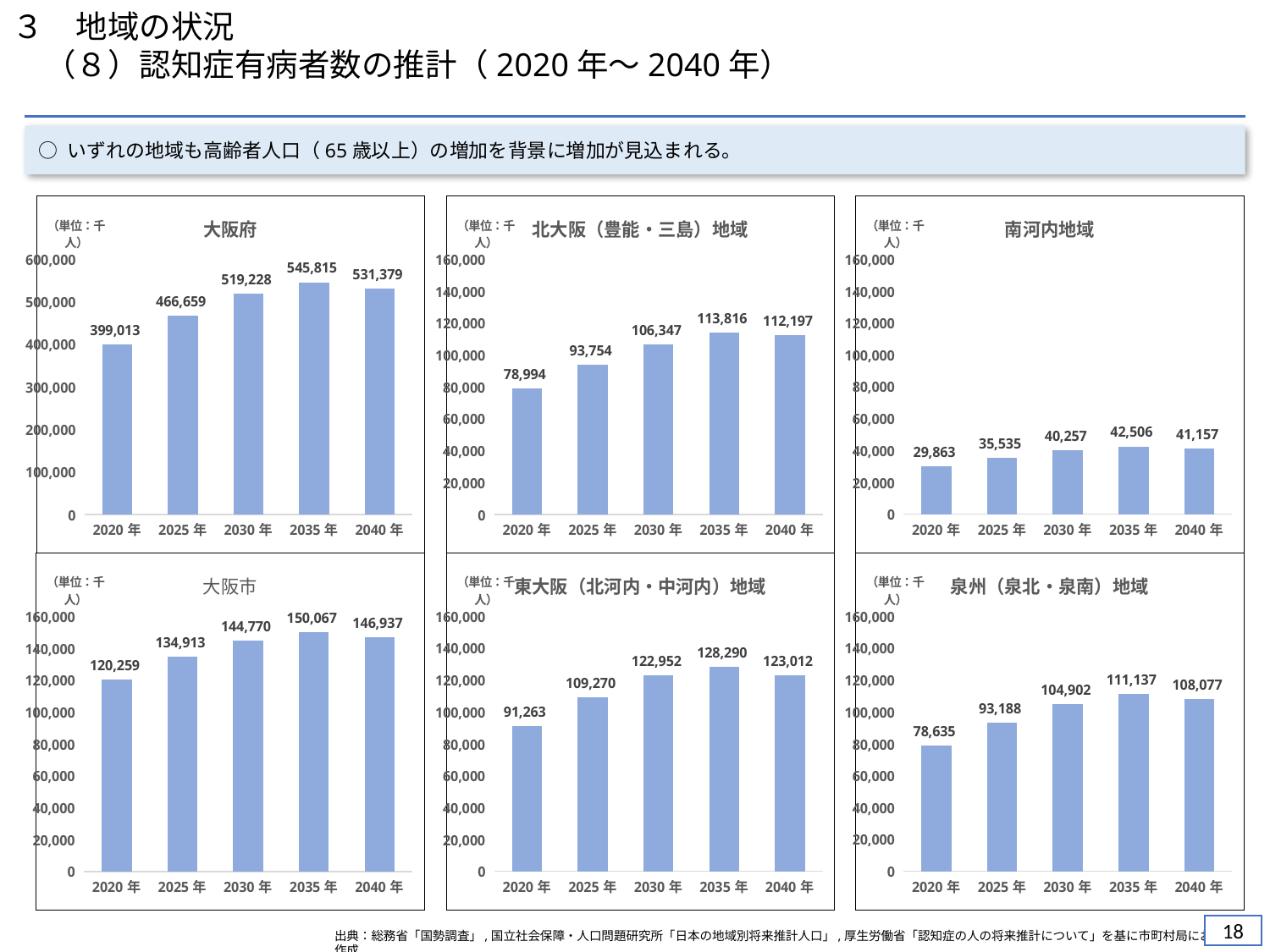
In the 大阪府 chart, what is the value for 2020年? 399,013 In the 南河内地域 chart, what is the difference between the 2035年 and 2020年 values? 12,643 In the 東大阪（北河内・中河内）地域 chart, do the values rise or fall from 2020年 to 2035年? Rise In the 北大阪（豊能・三島）地域 chart, what is the value for 2040年? 112,197 In the 大阪府 chart, which year has the highest value? 2035年 In the 東大阪（北河内・中河内）地域 chart, what is the value for 2025年? 109,270 In the 南河内地域 chart, which year has the lowest value? 2020年 In the 大阪市 chart, which is larger, the value for 2035年 or the value for 2040年? 2035年 In the 大阪市 chart, what is the value for 2030年? 144,770 How many years (categories) are shown in the 泉州（泉北・泉南）地域 chart? 5 What type of chart is the 大阪府 chart? Bar chart In the 泉州（泉北・泉南）地域 chart, what is the difference between the 2040年 and 2020年 values? 29,442